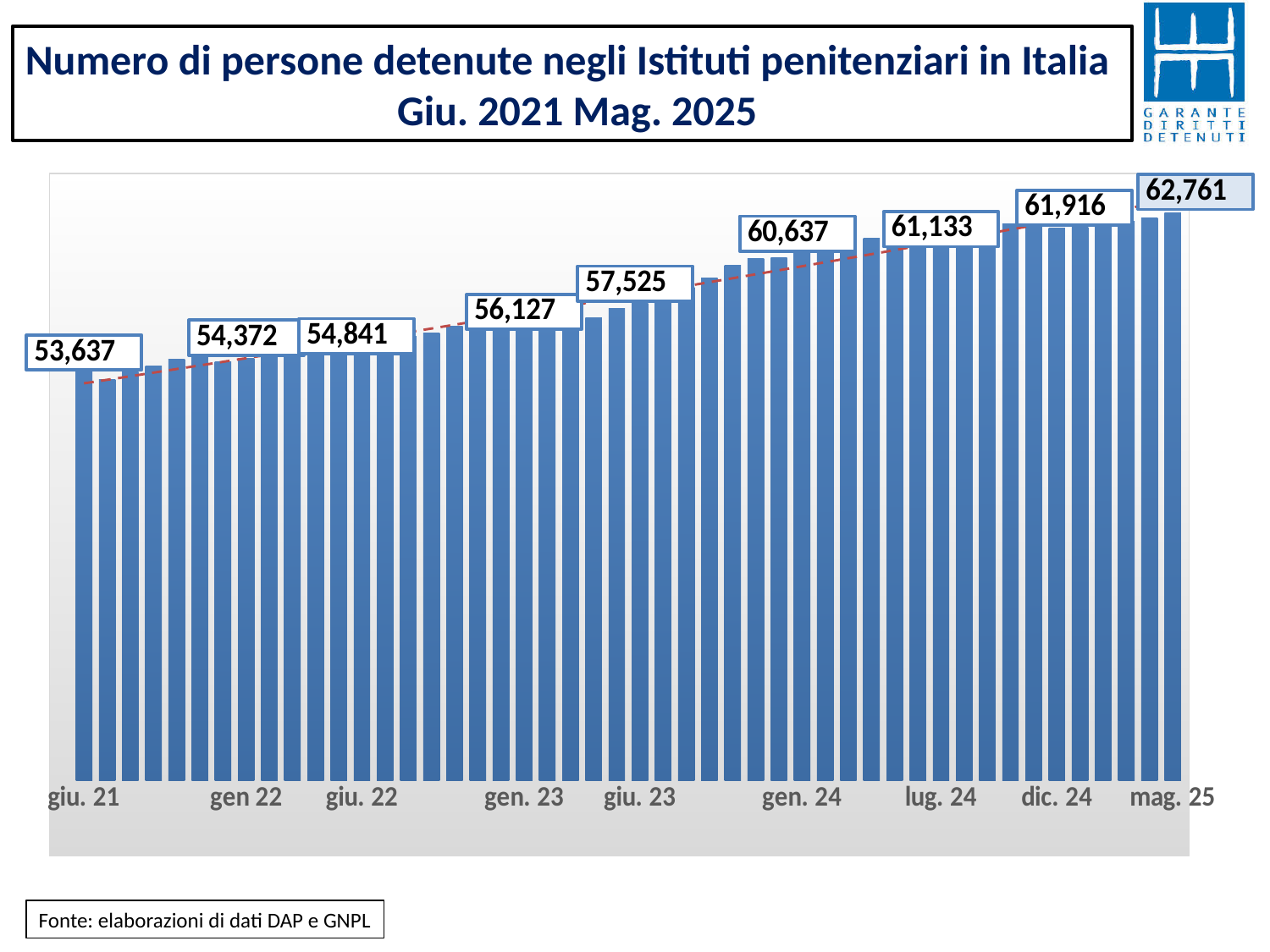
What value is labelled for mag. 25? 62,761 What kind of chart is shown on the slide? bar chart What value is labelled for gen 22? 54,372 Which labelled period has the highest value? mag. 25 What is the difference between the values labelled for mag. 25 and giu. 21? 9,124 What value is labelled for giu. 23? 57,525 What value is labelled for giu. 22? 54,841 Which labelled period has the lowest value? giu. 21 Do the values generally rise or fall from giu. 21 to mag. 25? rise What is the number of detained persons shown for giu. 21? 53,637 What value is labelled for gen. 24? 60,637 What value is labelled for gen. 23? 56,127